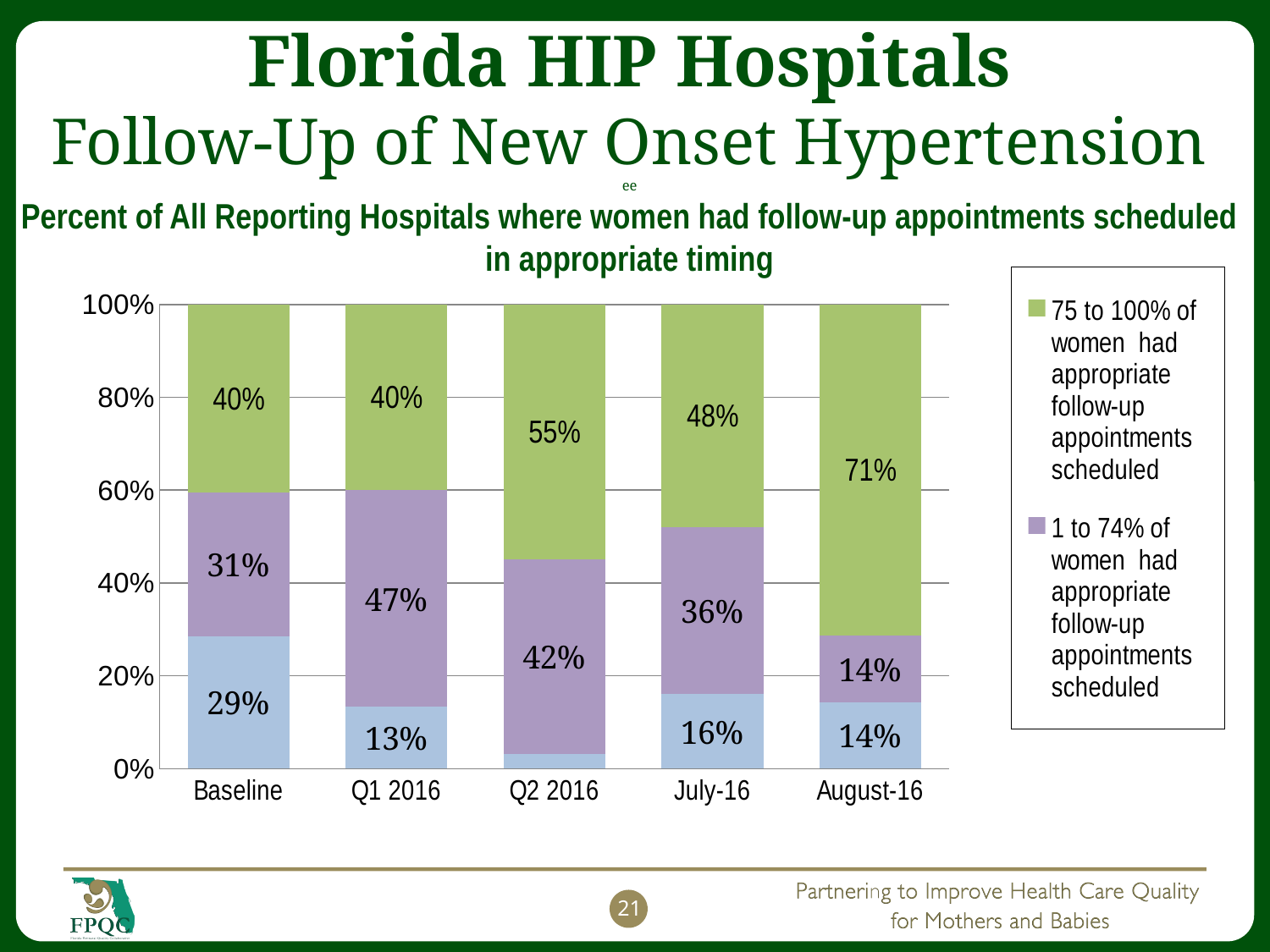
What is the value of the '75 to 100% of women had appropriate follow-up appointments scheduled' segment for Q2 2016? 55% How many series does the chart's legend list? 2 Does the '75 to 100% of women had appropriate follow-up appointments scheduled' series rise or fall from July-16 to August-16? rise What is the value of the '75 to 100% of women had appropriate follow-up appointments scheduled' segment for August-16? 71% How many categories are shown along the x axis of the chart? 5 Which category has the lowest value for the '1 to 74% of women had appropriate follow-up appointments scheduled' series? August-16 What colour represents the '75 to 100% of women had appropriate follow-up appointments scheduled' series? green What is the difference between the '75 to 100%' segment values for August-16 and Baseline? 31% Which is larger: the '1 to 74%' segment for Q2 2016 or for July-16? Q2 2016 What kind of chart is shown on the slide? stacked bar chart Which category has the highest value for the '75 to 100% of women had appropriate follow-up appointments scheduled' series? August-16 What is the value of the '1 to 74% of women had appropriate follow-up appointments scheduled' segment for Q1 2016? 47%